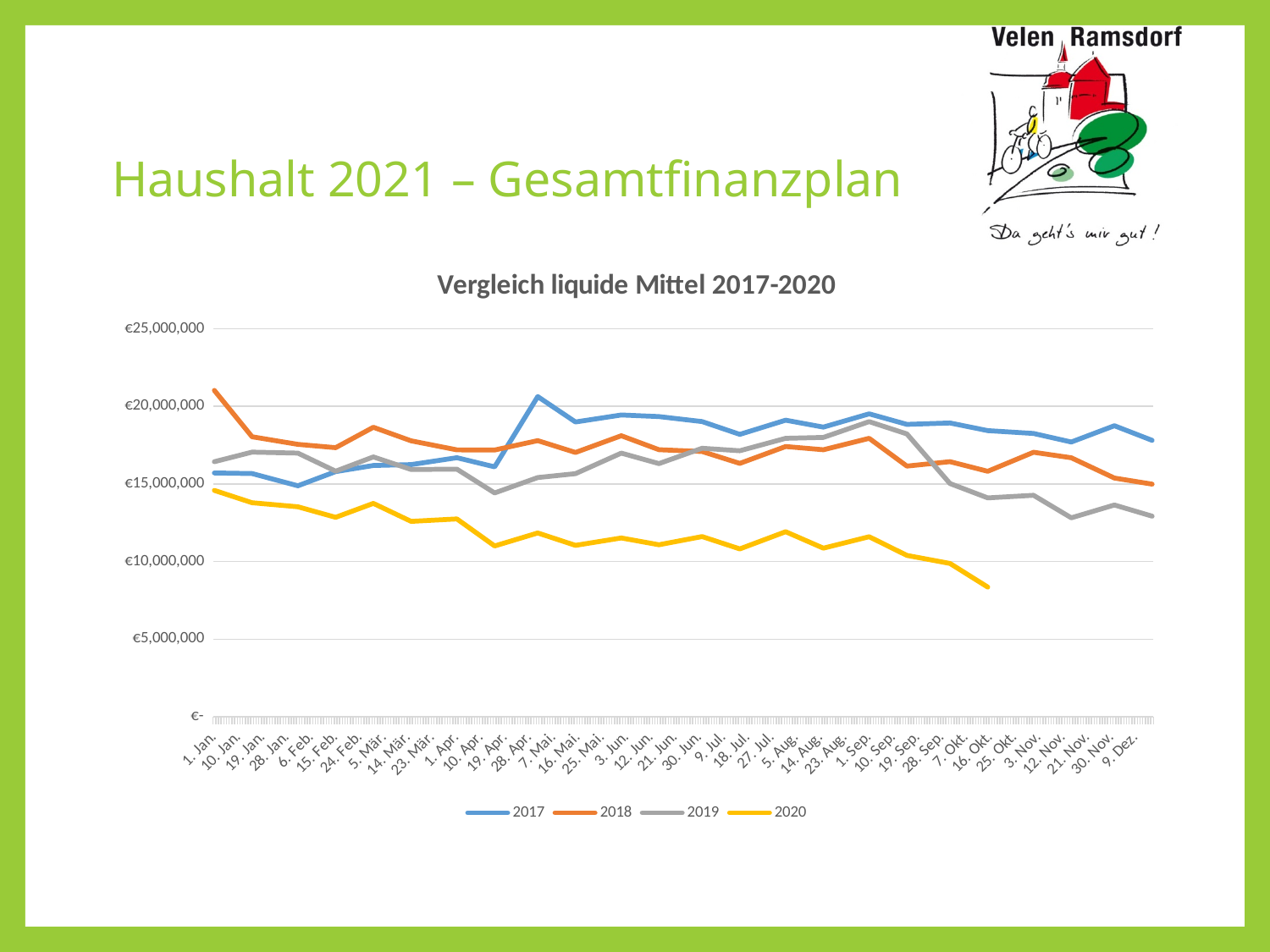
How many series does the legend of the chart list? 4 Which series has the lowest values across the whole year? 2020 On 9. Dez., which is larger: the value for 2017 or the value for 2019? 2017 Which colour is used for the 2020 series in the chart? yellow What is the title of the chart? Vergleich liquide Mittel 2017-2020 What kind of chart is shown on the slide? line chart Is the value for 2019 on 9. Dez. greater or less than €15,000,000? less Is the value for 2020 on 1. Jan. greater or less than €15,000,000? less Which series has the highest value on 1. Jan.? 2018 Is the value for 2017 on 7. Mai greater or less than €20,000,000? greater